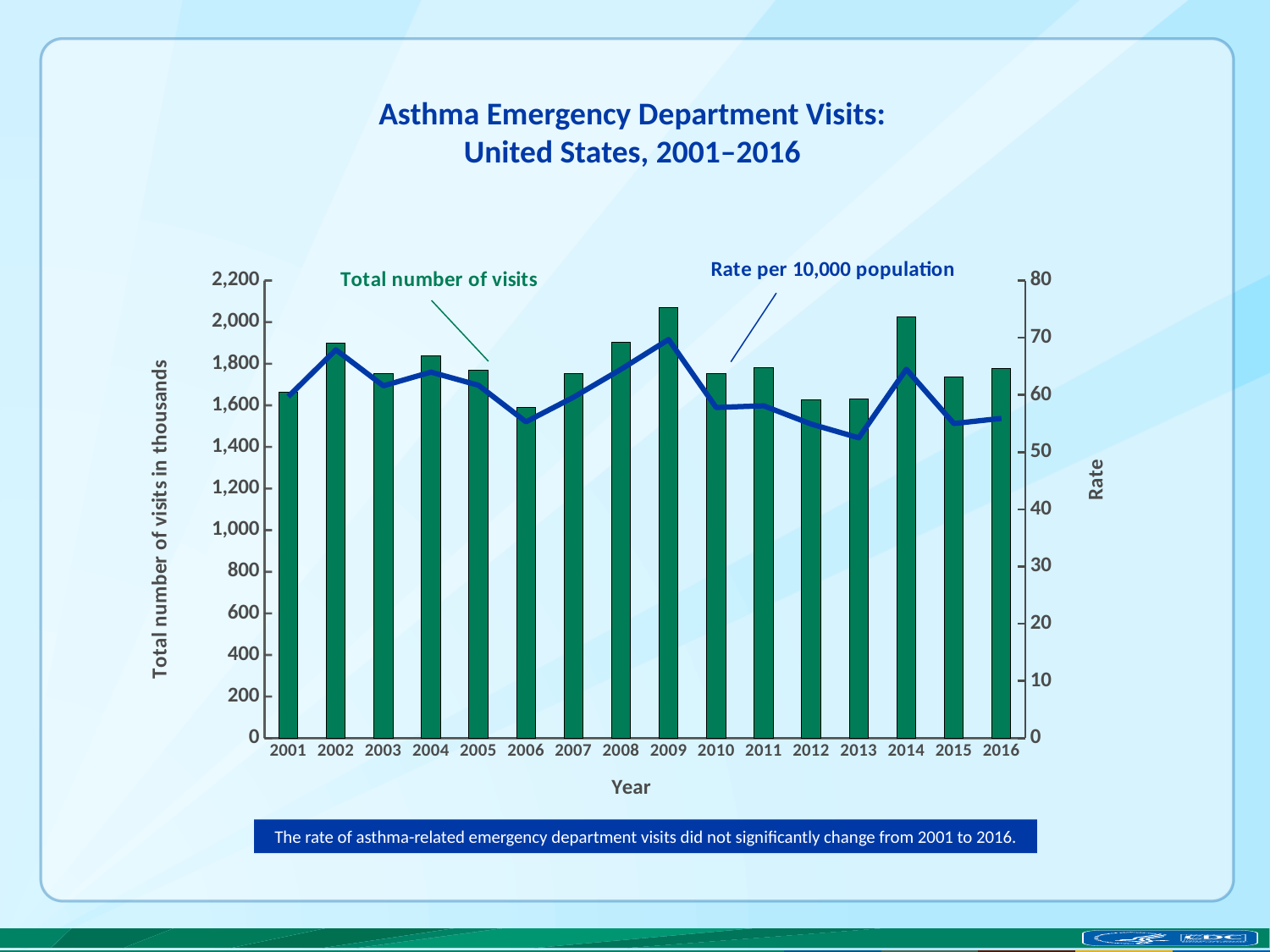
How many years are shown along the x axis of the chart? 16 Which year has the larger total number of visits bar, 2014 or 2013? 2014 Which year has the highest bar for total number of visits? 2009 What is the label on the left vertical axis of the chart? Total number of visits in thousands What kind of chart is shown on the slide? A bar chart combined with a line Is the total number of visits bar for 2006 greater or less than 1,800? less How many data series does the chart show? 2 Is the rate per 10,000 population for 2013 greater or less than 60? less In which year is the rate per 10,000 population line at its lowest point? 2013 What is the title of the chart? Asthma Emergency Department Visits: United States, 2001–2016 Is the total number of visits bar for 2009 greater or less than 2,000? greater